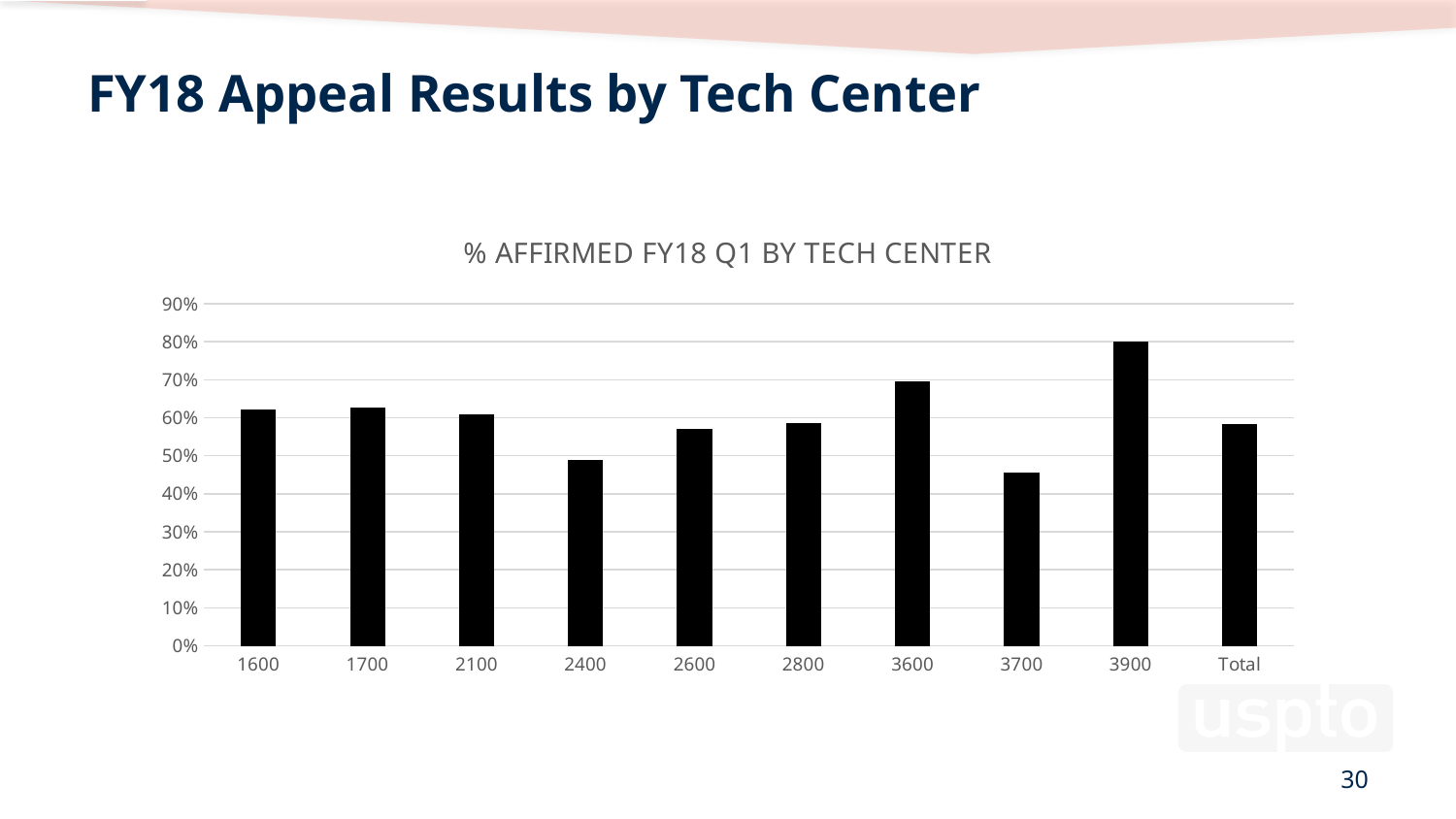
Which has a higher % affirmed, tech center 1600 or tech center 3700? 1600 Is the value for tech center 3600 greater or less than 60%? greater What colour are the bars in the chart? black Which tech center has the highest % affirmed? 3900 Is the value for Total greater or less than 60%? less Is the value for tech center 3900 greater or less than 70%? greater How many categories are shown on the x axis of the chart? 10 Which has a higher % affirmed, tech center 3600 or tech center 2400? 3600 Which tech center has the lowest % affirmed? 3700 What is the title of the chart? % AFFIRMED FY18 Q1 BY TECH CENTER What kind of chart is shown on the slide? bar chart